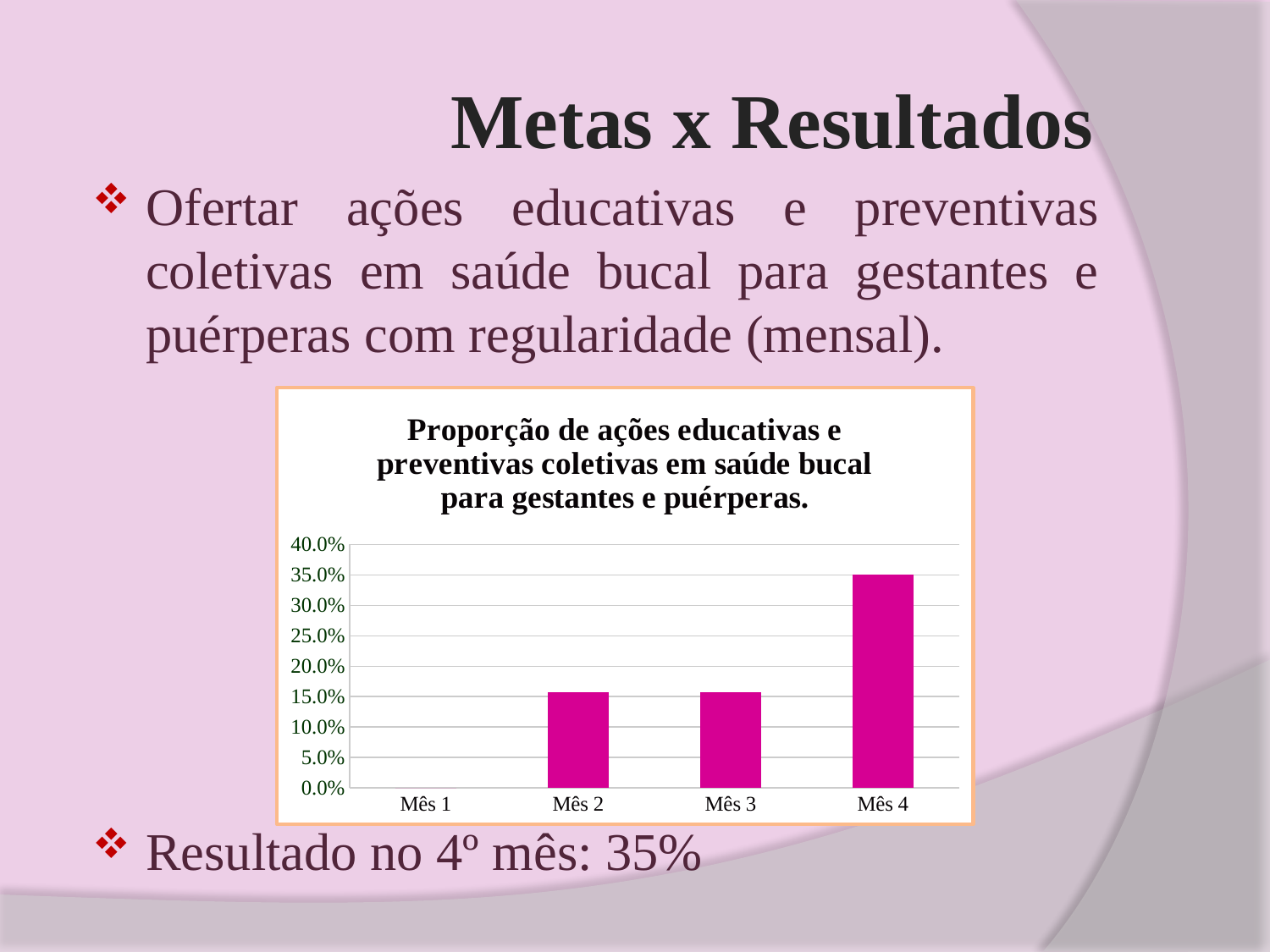
What is the title of the chart? Proporção de ações educativas e preventivas coletivas em saúde bucal para gestantes e puérperas. What is the difference between the value for Mês 4 and the value for Mês 1? 35% Which is larger, the value for Mês 4 or the value for Mês 2? Mês 4 What is the value for Mês 4 in the chart? 35% Which month has the highest value in the chart? Mês 4 How many categories (months) are shown on the x axis of the chart? 4 Which month has the lowest value in the chart? Mês 1 What is the value for Mês 1 in the chart? 0.0% What kind of chart is shown on the slide? bar chart Is the value for Mês 2 greater or less than 10.0%? greater Is the value for Mês 3 greater or less than 20.0%? less Do the values generally rise or fall from Mês 1 to Mês 4? rise